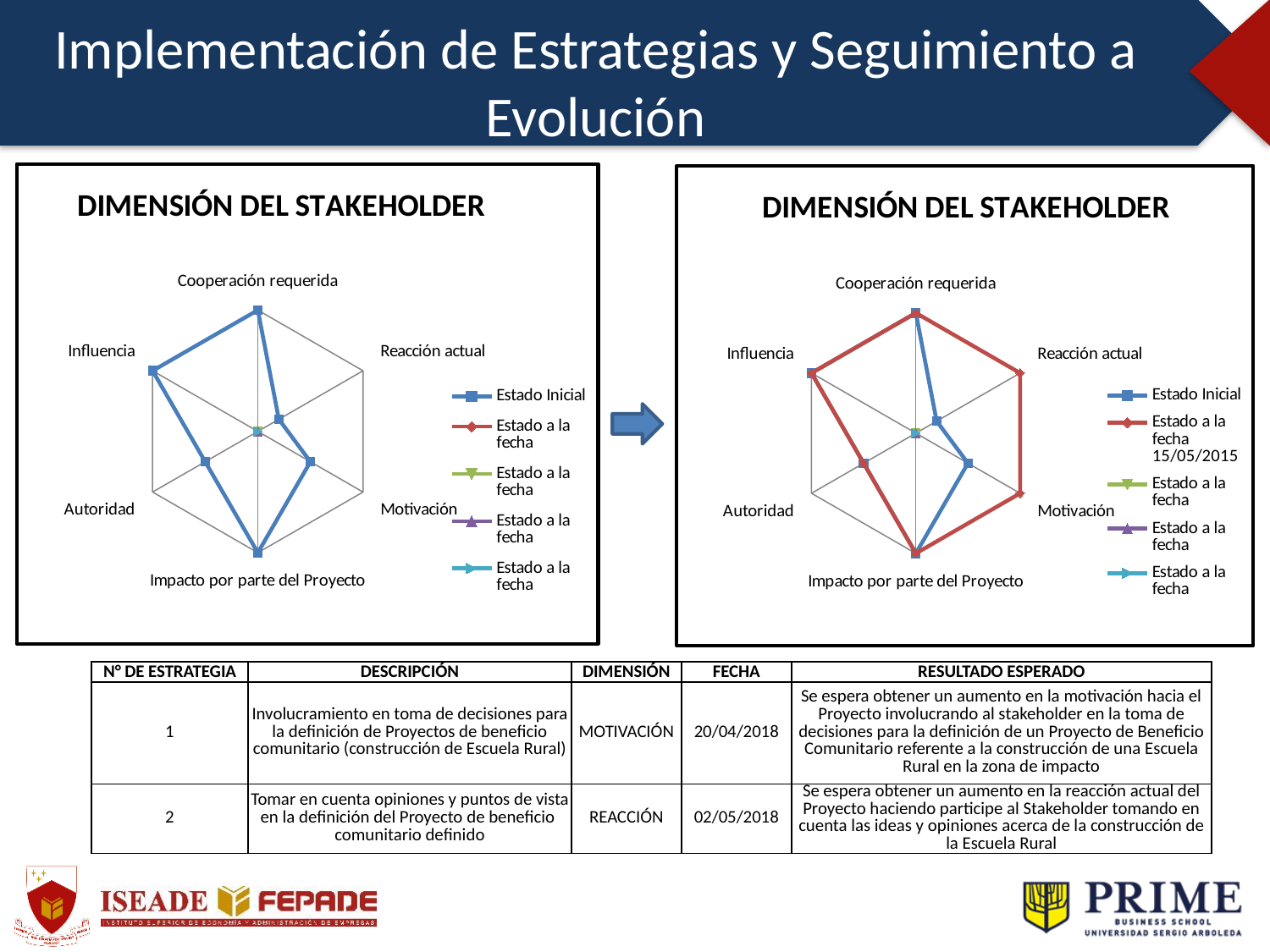
How many series does the legend of the right chart list? 5 How many categories (axes) does the left radar chart have? 6 In the right chart, what date appears in the legend entry for the red series? 15/05/2015 In the right chart, for Reacción actual, which series has the larger value: Estado Inicial or Estado a la fecha 15/05/2015? Estado a la fecha 15/05/2015 What is the title of the left chart? DIMENSIÓN DEL STAKEHOLDER What type of chart is the right chart on the slide? Radar chart In the left chart, which category has the lowest value for the Estado Inicial series? Reacción actual In the left chart, for the Estado Inicial series, which is larger: Motivación or Reacción actual? Motivación What type of chart is the left chart on the slide? Radar chart In the right chart, for Motivación, which series has the larger value: Estado Inicial or Estado a la fecha 15/05/2015? Estado a la fecha 15/05/2015 In the right chart, which category has the lowest value for the Estado a la fecha 15/05/2015 series? Autoridad